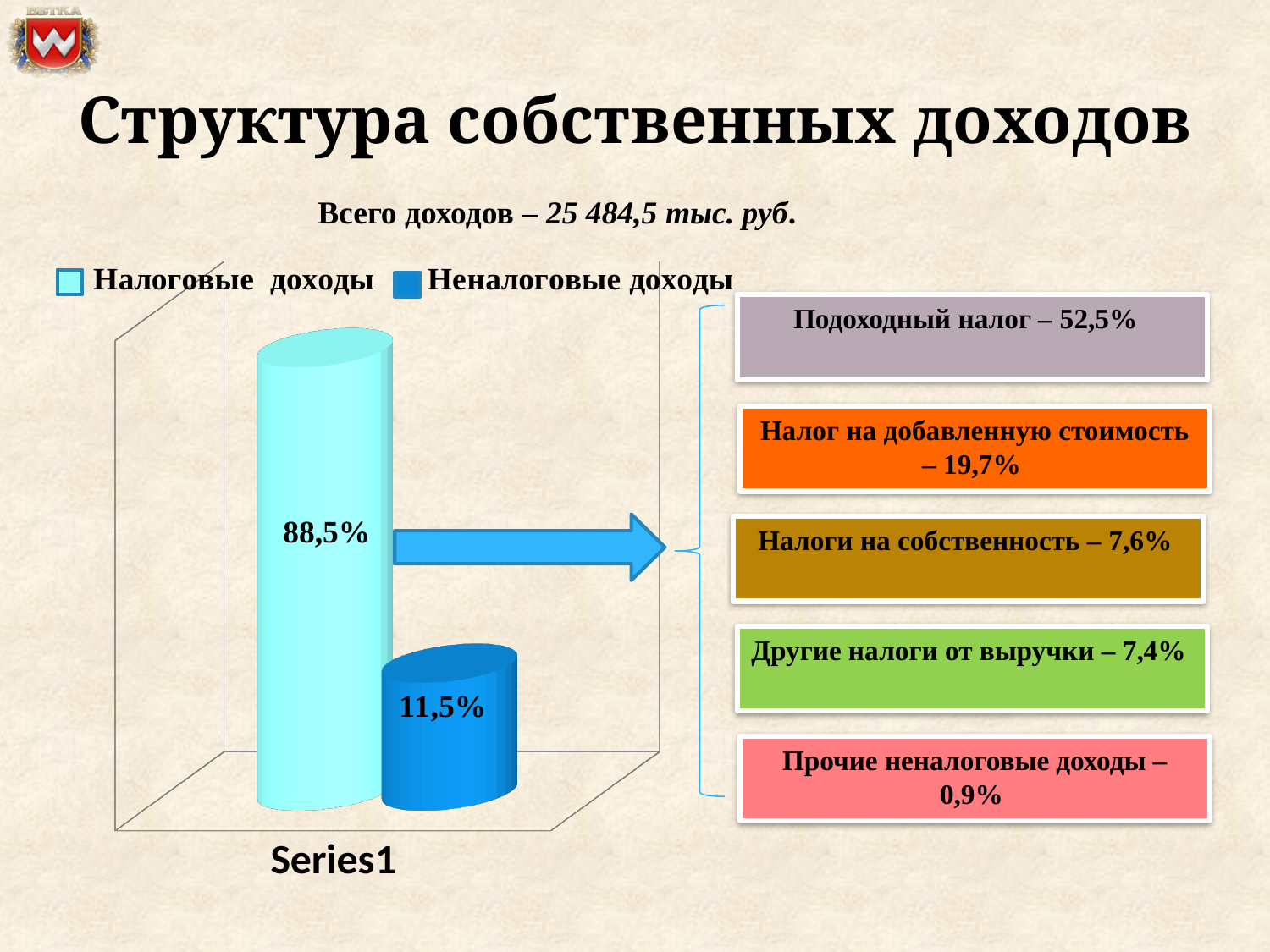
What colour is the bar for Неналоговые доходы? blue What is the value shown for Налоговые доходы? 88,5% What is the category label shown under the bars? Series1 Which series has the lower value in the chart? Неналоговые доходы Is the value for Неналоговые доходы larger or smaller than the value for Налоговые доходы? smaller What is the value shown for Неналоговые доходы? 11,5% What kind of chart is shown on the slide? bar chart What is the difference between the values for Налоговые доходы and Неналоговые доходы? 77% How many series does the legend list? 2 Which series has the higher value, Налоговые доходы or Неналоговые доходы? Налоговые доходы What is the total of the two values shown in the chart? 100%